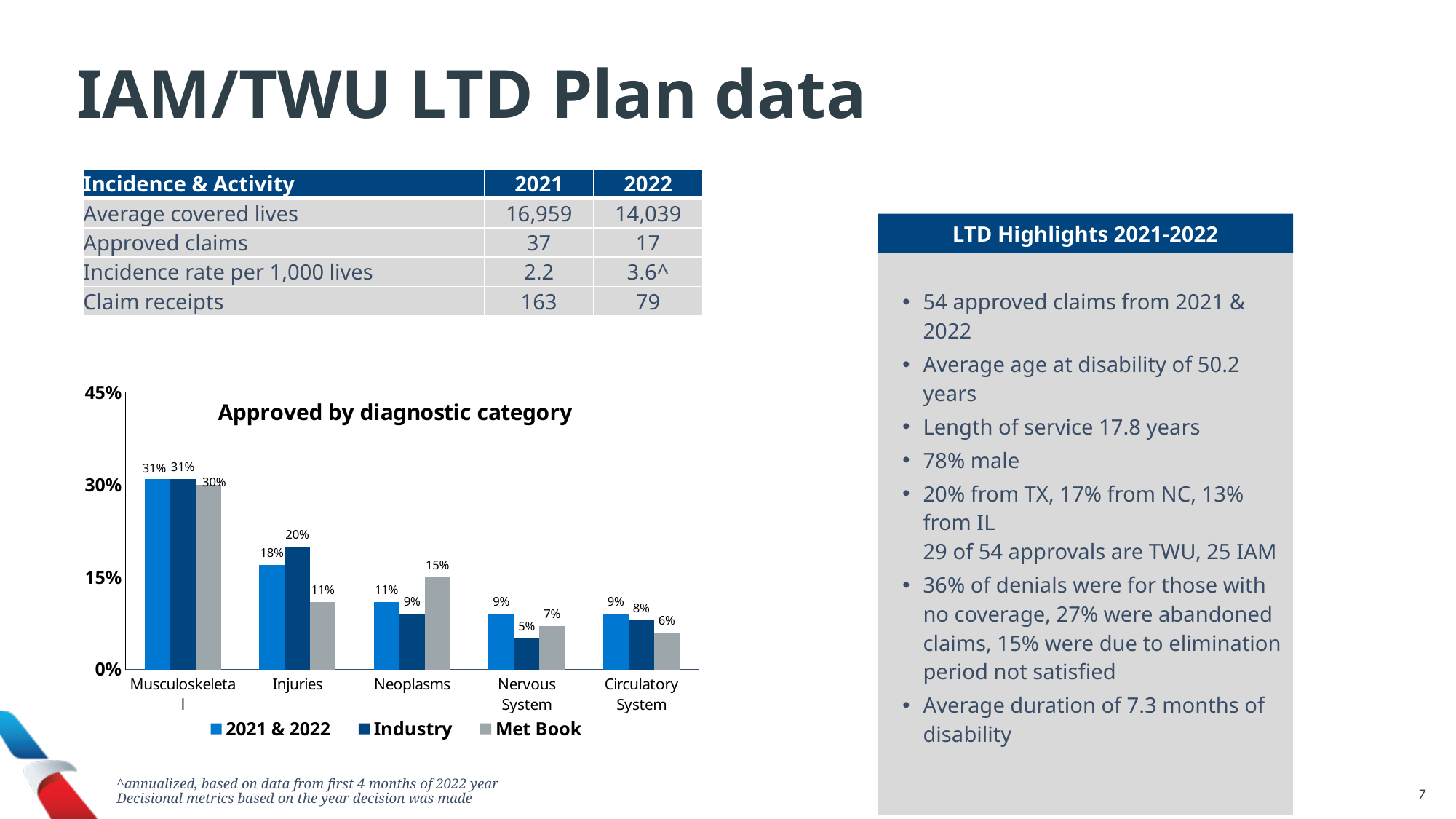
How many series does the legend of the 'Approved by diagnostic category' chart list? 3 In the 'Approved by diagnostic category' chart, what is the difference between the Industry and Met Book values for Injuries? 9% In the 'Approved by diagnostic category' chart, what is the 2021 & 2022 value for Injuries? 18% What kind of chart is 'Approved by diagnostic category'? Bar chart In the 'Approved by diagnostic category' chart, is the Industry value for Musculoskeletal greater or less than 30%? greater In the 'Approved by diagnostic category' chart, which category has the highest 2021 & 2022 value? Musculoskeletal What are the three series named in the legend of the 'Approved by diagnostic category' chart? 2021 & 2022, Industry, Met Book In the 'Approved by diagnostic category' chart, which is larger for Neoplasms: the 2021 & 2022 value or the Met Book value? Met Book In the 'Approved by diagnostic category' chart, what is the Met Book value for Neoplasms? 15% In the 'Approved by diagnostic category' chart, which category has the lowest Met Book value? Circulatory System In the 'Approved by diagnostic category' chart, what is the Industry value for Nervous System? 5% How many diagnostic categories are shown on the x axis of the 'Approved by diagnostic category' chart? 5